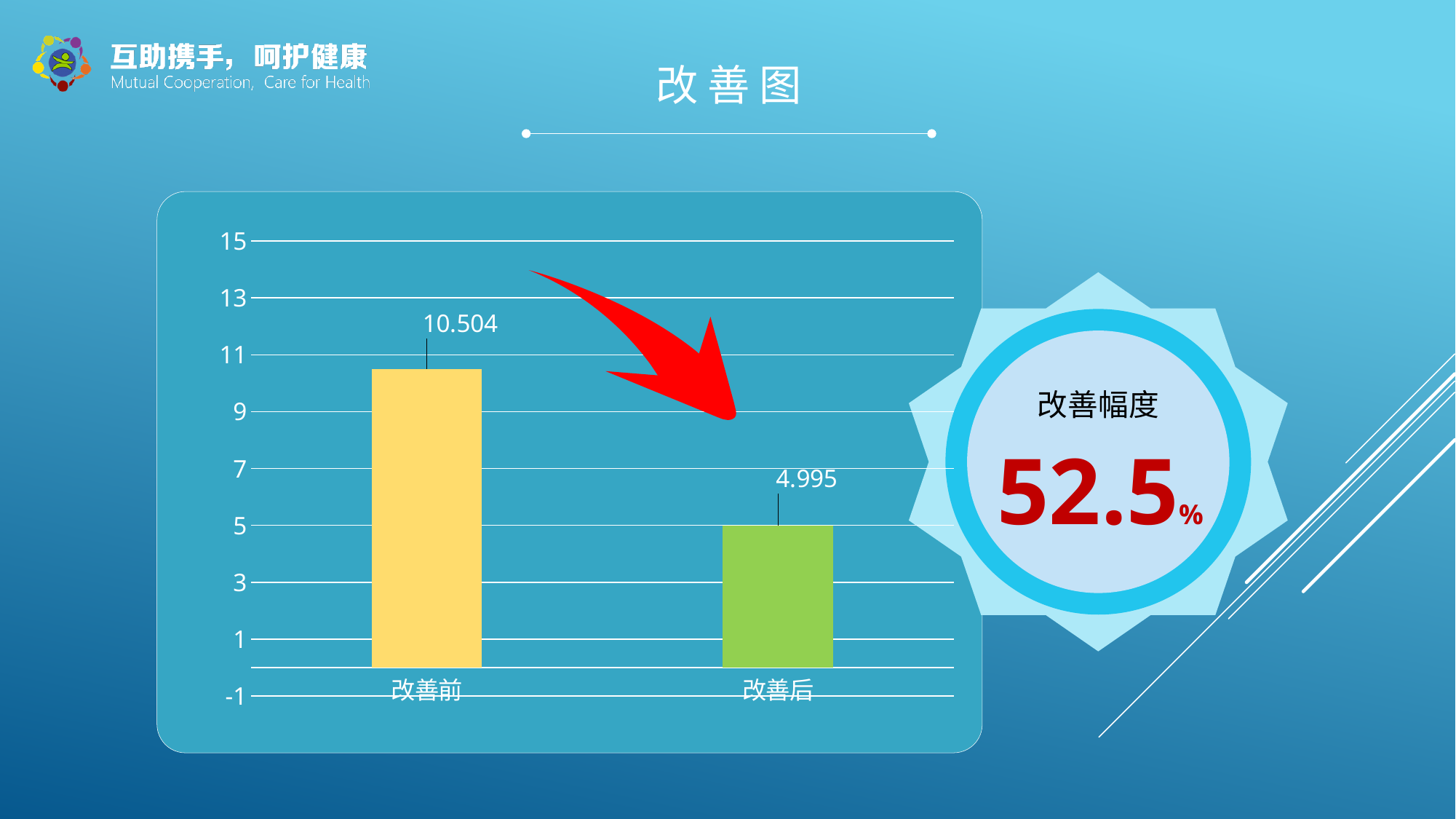
How many categories are shown on the x axis? 2 What is the title of the slide containing the chart? 改善图 What is the value for 改善前? 10.504 What is the value for 改善后? 4.995 Is the value for 改善前 greater or less than 9? greater Is the value for 改善后 greater or less than 7? less Which category has the highest value? 改善前 Which category has the lowest value? 改善后 Do the values rise or fall from 改善前 to 改善后? fall What kind of chart is shown on the slide? bar chart What is the difference between the values for 改善前 and 改善后? 5.509 Which is larger, the value for 改善前 or the value for 改善后? 改善前